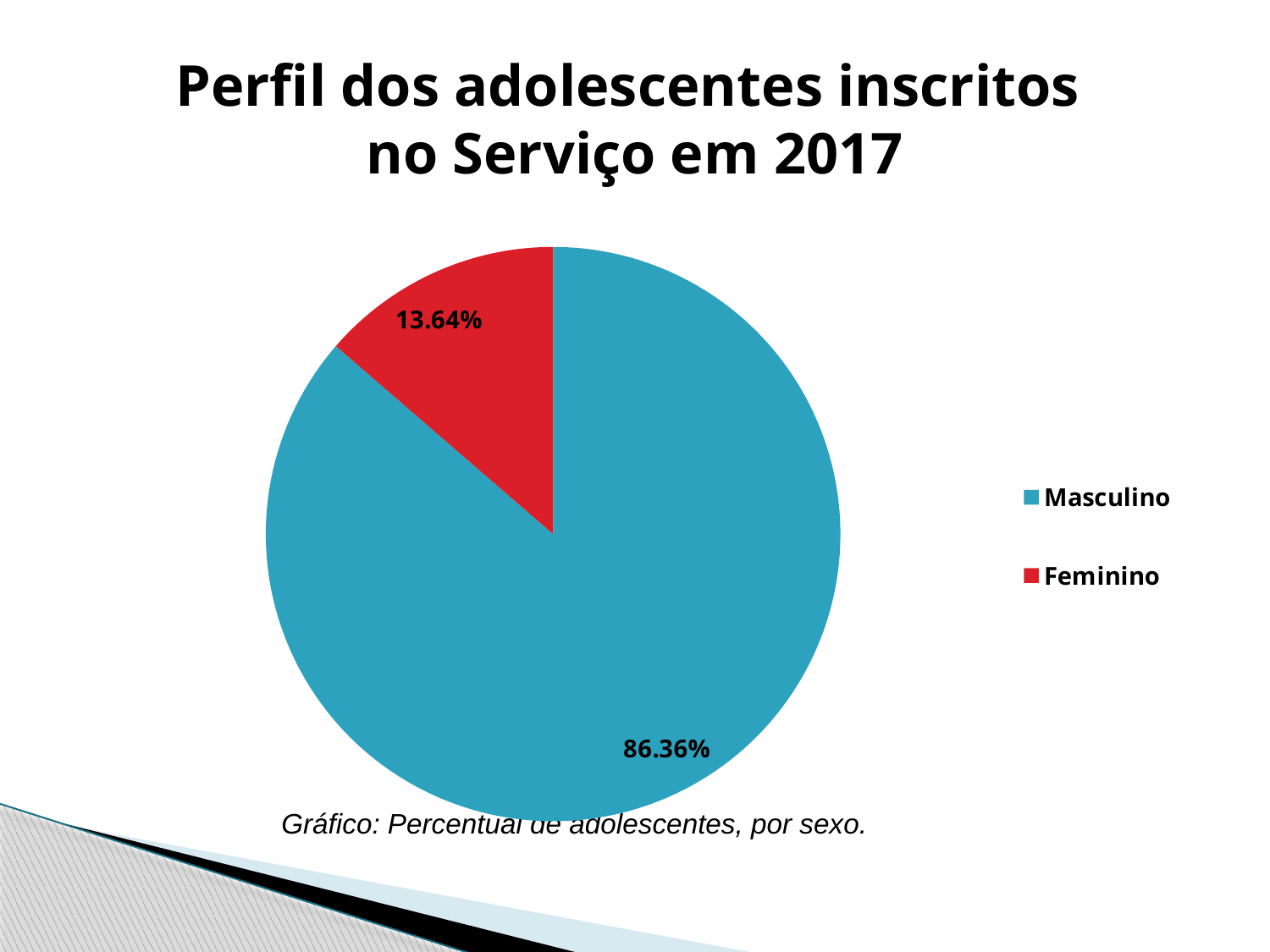
What is the difference in percentage points between the Masculino and Feminino slices? 72.72 How many slices does the pie chart have? 2 What share of the pie does the Feminino slice represent? 13.64% How many entries does the legend list? 2 Which slice is larger, Masculino or Feminino? Masculino Which category has the smallest slice of the pie chart? Feminino Which category has the largest slice of the pie chart? Masculino What is the caption below the pie chart? Gráfico: Percentual de adolescentes, por sexo. What colour is the Masculino slice in the pie chart? Blue What kind of chart is shown on the slide? Pie chart What percentage of the pie chart is Feminino? 13.64% What percentage of the pie chart is Masculino? 86.36%